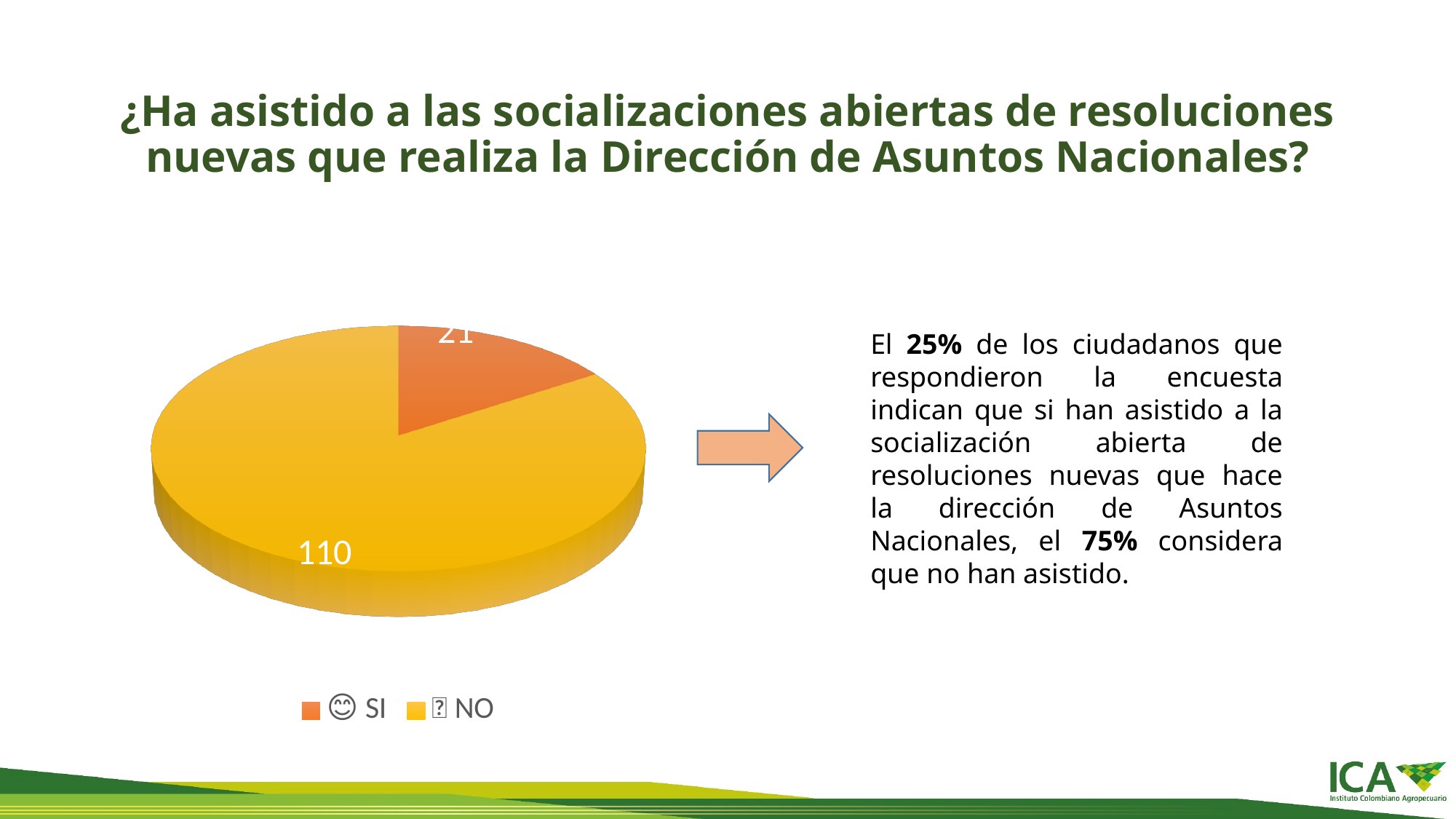
How many entries does the legend of the pie chart list? 2 What is the value for the SI slice of the pie chart? 21 What colour is the NO slice in the pie chart? Yellow Which category has the smallest slice in the pie chart? SI What colour is the SI slice in the pie chart? Orange What is the total of the two values shown in the pie chart? 131 Which category has the largest slice in the pie chart? NO What is the difference between the NO value and the SI value in the pie chart? 89 Which is larger in the pie chart, SI or NO? NO What is the value for the NO slice of the pie chart? 110 How many slices does the pie chart have? 2 What type of chart is shown on the slide? Pie chart